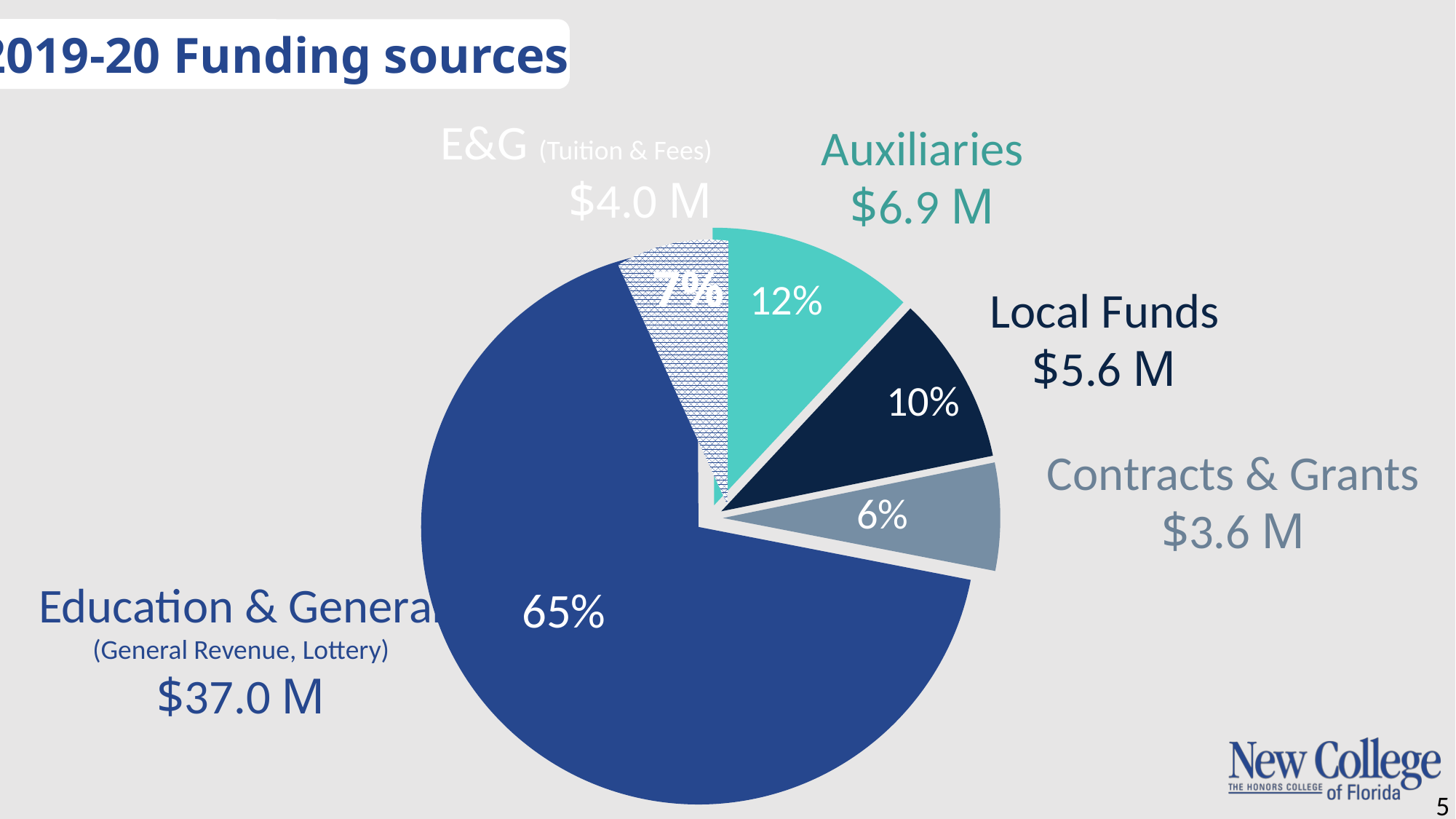
What is the title of the slide's chart? 2019-20 Funding sources How many slices does the pie chart have? 5 Which funding source is the largest? Education & General (General Revenue, Lottery) Which is larger, Auxiliaries or Local Funds? Auxiliaries Which funding source is the smallest? Contracts & Grants What share of the pie does Education & General (General Revenue, Lottery) represent? 65% What kind of chart is shown on the slide? Pie chart What is the dollar amount shown for Contracts & Grants? $3.6 M What is the difference in dollars between Auxiliaries and E&G (Tuition & Fees)? $2.9 M What is the dollar amount shown for Local Funds? $5.6 M What share of the pie does E&G (Tuition & Fees) represent? 7% What share of the pie does Auxiliaries represent? 12%